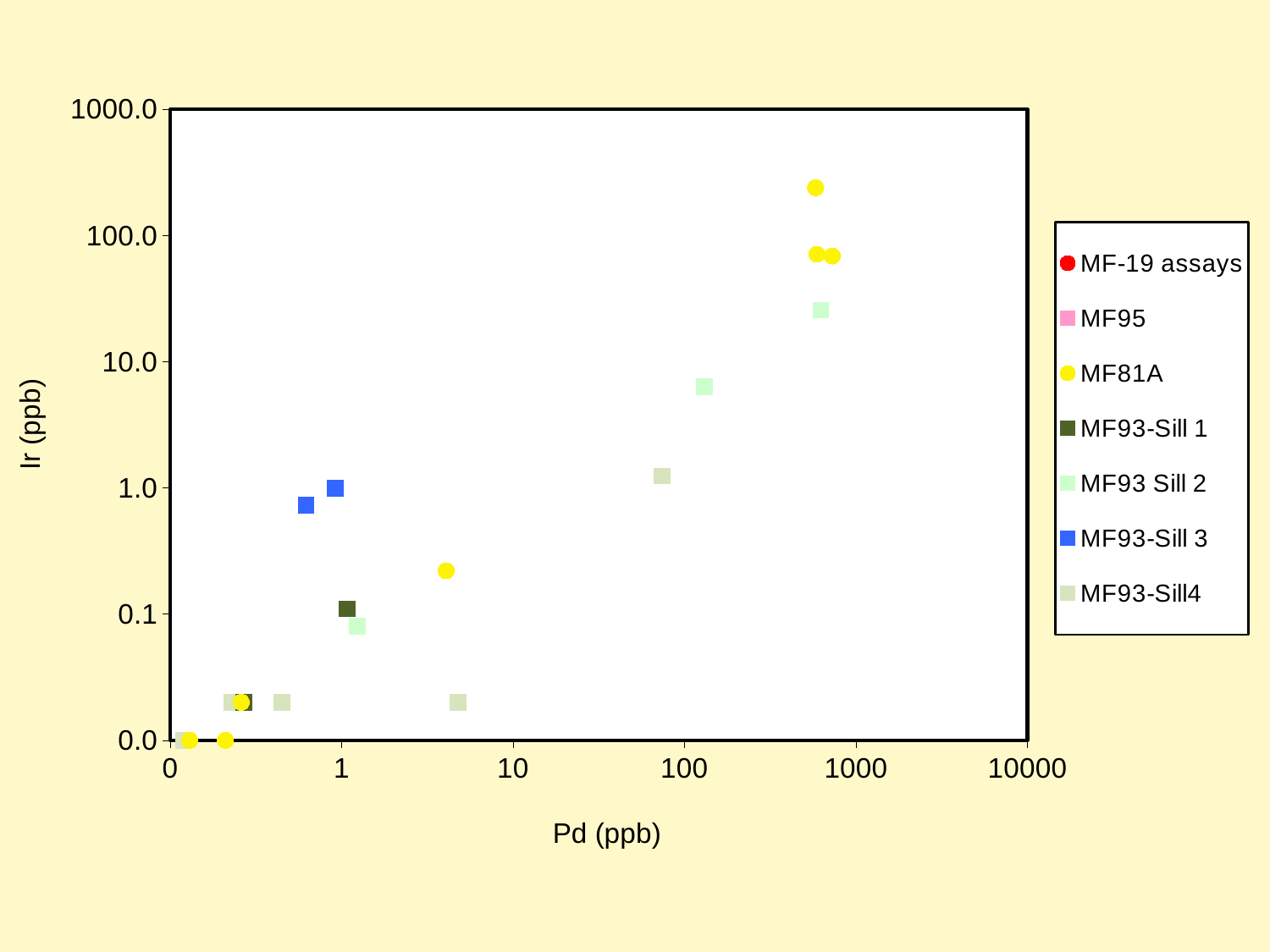
Overall, do Ir (ppb) values rise or fall as Pd (ppb) increases? rise Are the Pd (ppb) values of the MF93-Sill 3 points greater or less than 10? less Is the Ir (ppb) value of the highest MF93 Sill 2 point greater or less than 100.0? less What kind of chart is shown on the slide? scatter chart What is the label of the y axis? Ir (ppb) Is the Ir (ppb) value of the highest MF81A point greater or less than 100.0? greater How many MF93-Sill 3 points are plotted? 2 Near Pd = 1000, which series has the higher Ir (ppb) values, MF81A or MF93 Sill 2? MF81A Which series has the point with the highest Ir (ppb) value? MF81A How many series does the legend list? 7 What is the label of the x axis? Pd (ppb)